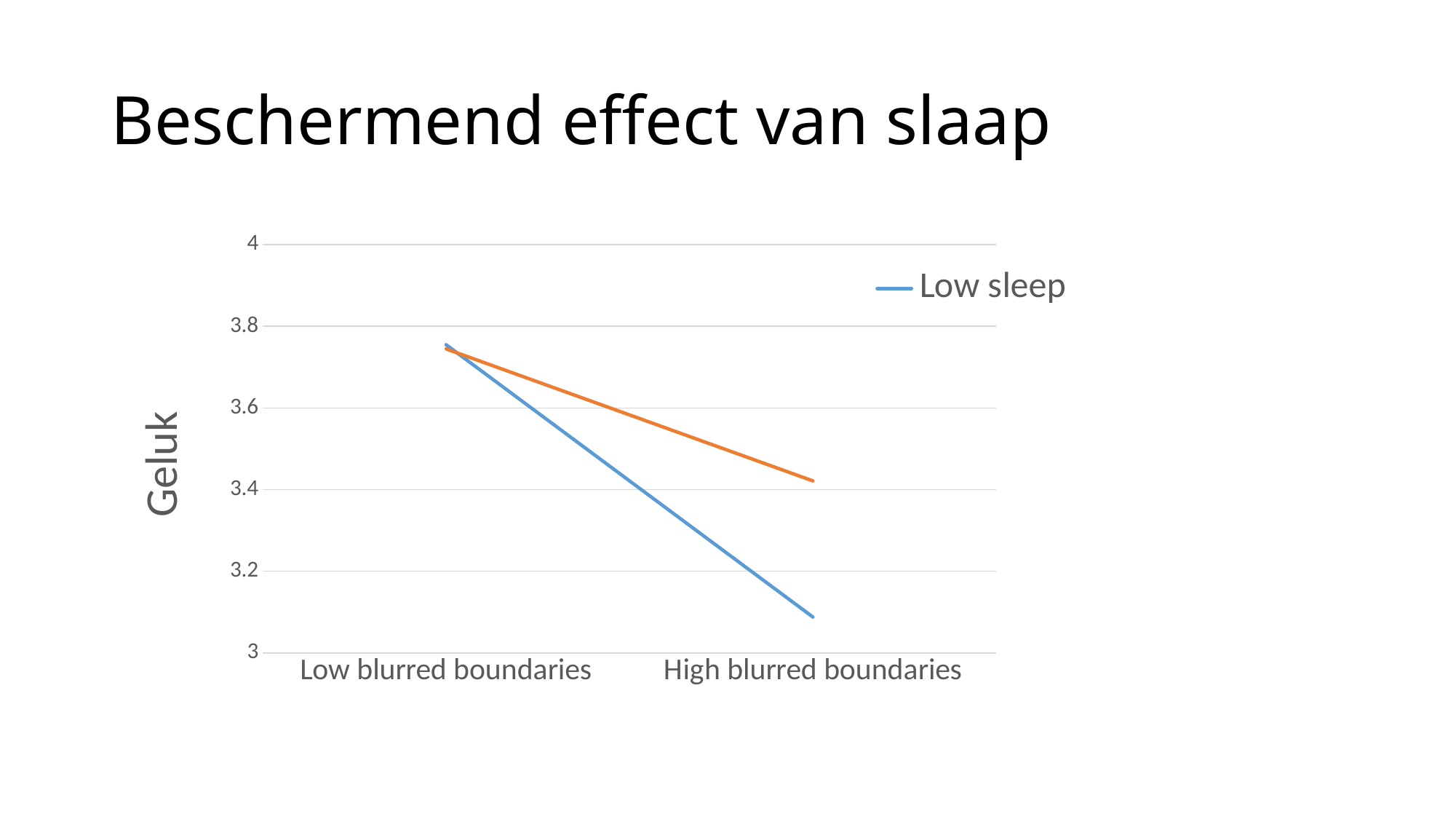
How many categories are shown on the x axis? 2 Does the Low sleep line rise or fall from Low blurred boundaries to High blurred boundaries? fall What kind of chart is shown on the slide? line chart For the Low sleep series, which category has the higher value? Low blurred boundaries Is the Low sleep value for Low blurred boundaries greater or less than 3.6? greater What is the label on the vertical axis? Geluk What series name is listed in the legend? Low sleep Is the orange line's value for High blurred boundaries greater or less than 3.2? greater At High blurred boundaries, which line is higher: the blue Low sleep line or the orange line? the orange line Is the Low sleep value for High blurred boundaries greater or less than 3.2? less How many series does the legend list? 1